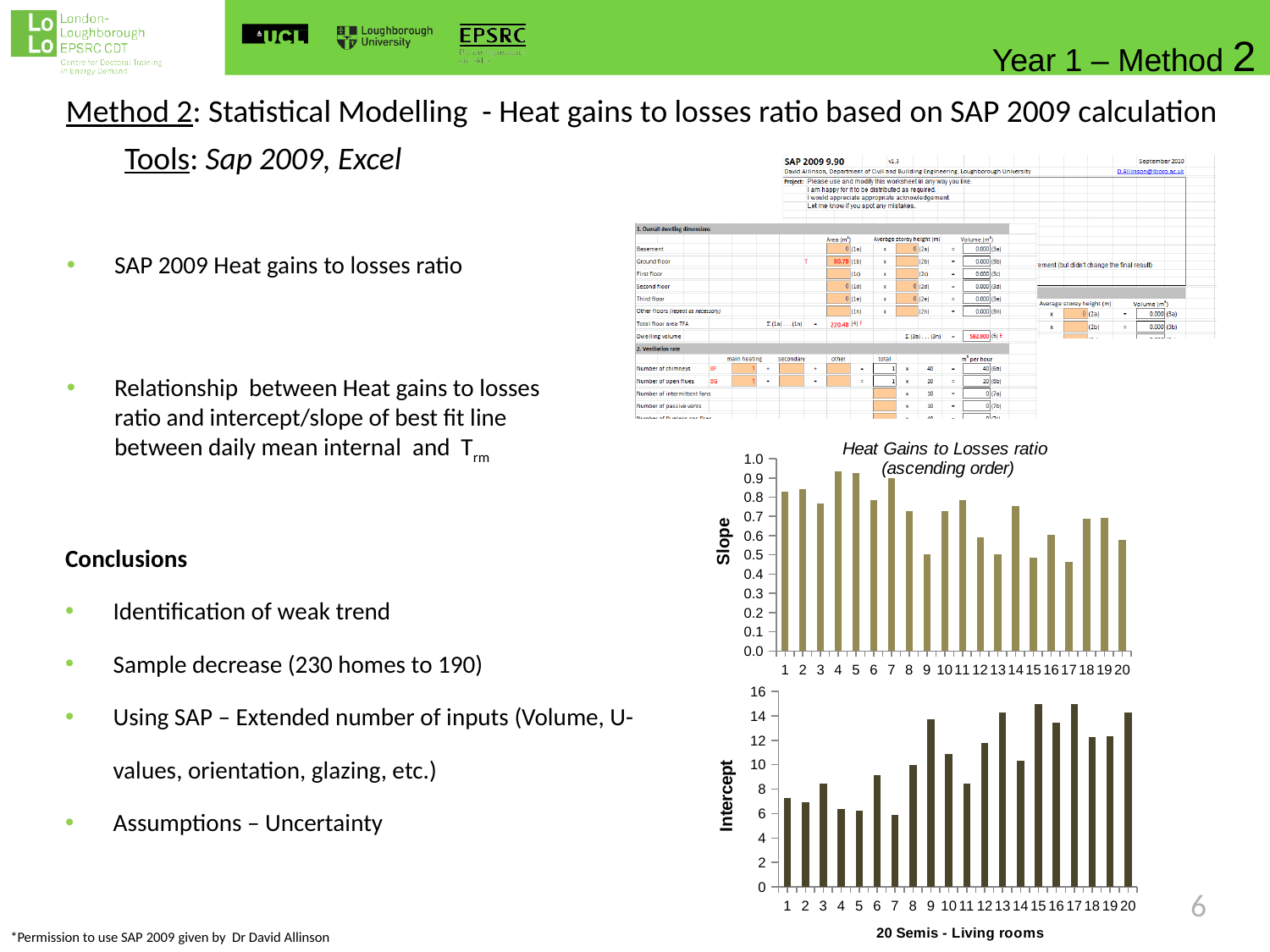
In the top chart titled 'Heat Gains to Losses ratio (ascending order)', which has the larger value, category 4 or category 17? category 4 In the bottom chart with the y-axis 'Intercept', is the value for category 9 greater or less than 12? greater In the top chart titled 'Heat Gains to Losses ratio (ascending order)', is the value for category 1 greater or less than 0.8? greater How many bars are plotted in the top chart titled 'Heat Gains to Losses ratio (ascending order)'? 20 What is the x-axis title of the bottom chart with the y-axis 'Intercept'? 20 Semis - Living rooms What kind of chart is the top chart titled 'Heat Gains to Losses ratio (ascending order)'? bar chart How many bars are plotted in the bottom chart with the y-axis 'Intercept'? 20 In the bottom chart with the y-axis 'Intercept', is the value for category 1 greater or less than 8? less In the bottom chart with the y-axis 'Intercept', which has the larger value, category 15 or category 7? category 15 What is the y-axis title of the top chart titled 'Heat Gains to Losses ratio (ascending order)'? Slope